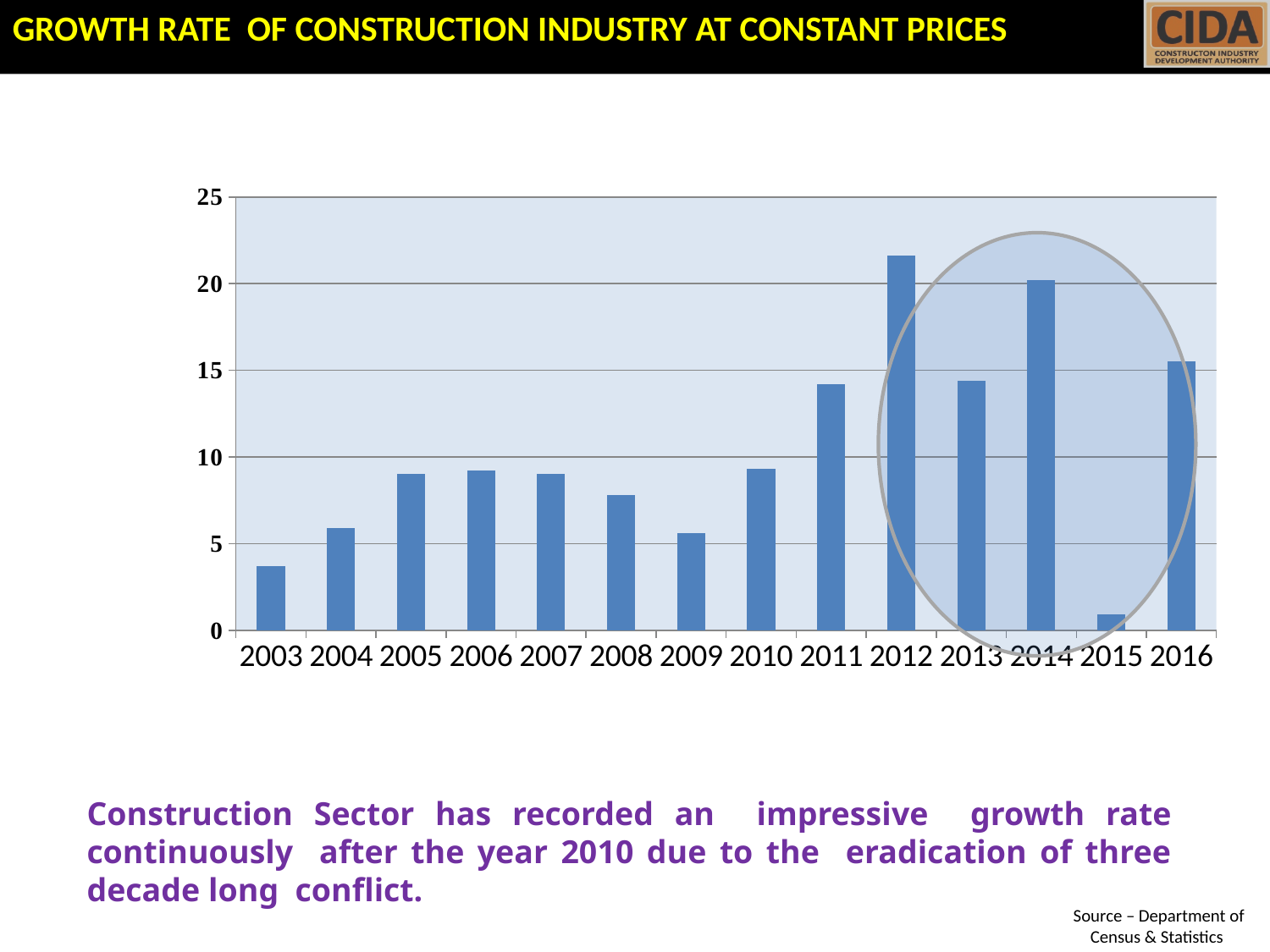
What kind of chart is shown on the slide? bar chart Is the value for 2008 greater or less than 10? less Is the value for 2015 greater or less than 5? less Which year has the highest growth rate in the chart? 2012 How many years are plotted on the x axis of the chart? 14 Which is larger, the value for 2003 or the value for 2004? 2004 Which is larger, the value for 2012 or the value for 2014? 2012 Is the value for 2012 greater or less than 20? greater Do the values rise or fall from 2006 to 2009? fall Which year has the lowest growth rate in the chart? 2015 What is the title of the chart on the slide? GROWTH RATE OF CONSTRUCTION INDUSTRY AT CONSTANT PRICES